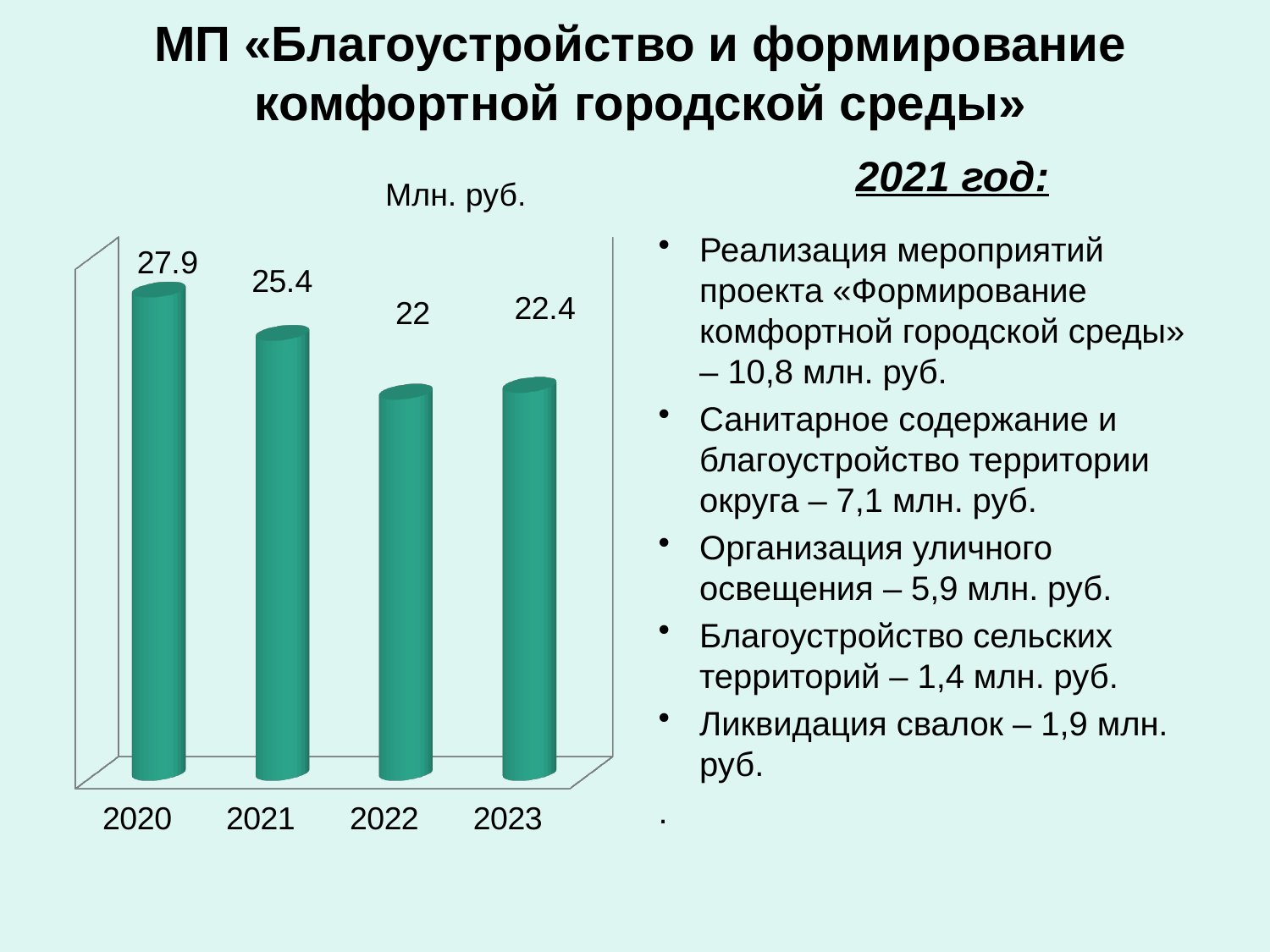
Do the values rise or fall from 2020 to 2022? fall What unit is shown above the chart? Млн. руб. What is the difference between the values for 2020 and 2021? 2.5 What is the value for 2020? 27.9 Which year has the lowest value? 2022 Which year has the highest value? 2020 What is the value for 2022? 22 What is the difference between the values for 2023 and 2022? 0.4 How many years are shown on the chart? 4 Which is larger, the value for 2021 or the value for 2023? 2021 What kind of chart is shown on the slide? bar chart What is the value for 2023? 22.4